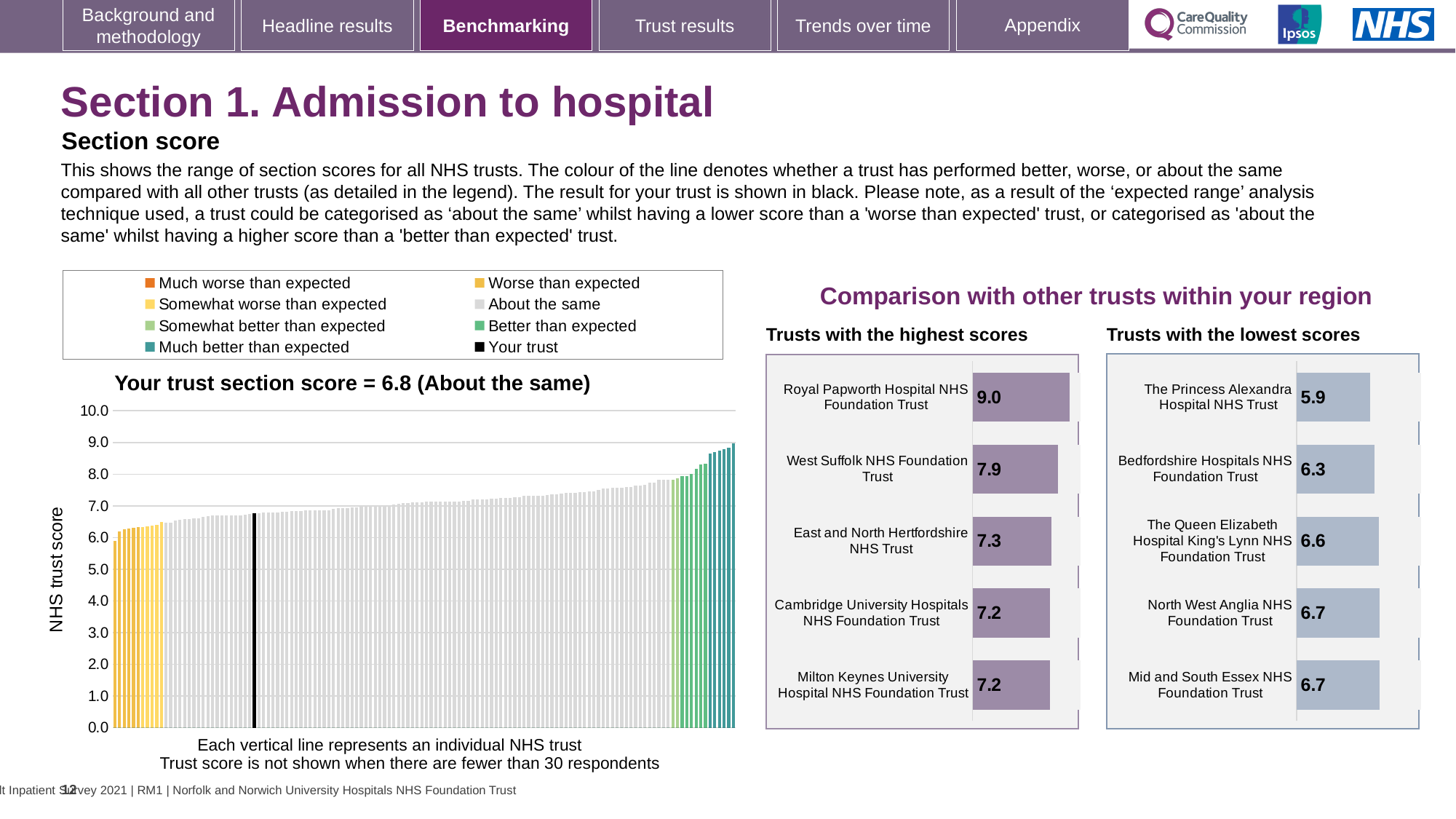
In the main chart on the left, is the value of the tallest bar greater or less than 8.0? greater In the 'Trusts with the highest scores' chart, what is the score for Royal Papworth Hospital NHS Foundation Trust? 9.0 In the 'Trusts with the lowest scores' chart, what is the score for Bedfordshire Hospitals NHS Foundation Trust? 6.3 How many entries does the legend above the main chart on the left list? 8 In the 'Trusts with the lowest scores' chart, which trust has the lowest score? The Princess Alexandra Hospital NHS Trust In the 'Trusts with the highest scores' chart, what is the difference between the scores of Royal Papworth Hospital NHS Foundation Trust and East and North Hertfordshire NHS Trust? 1.7 In the 'Trusts with the lowest scores' chart, which is larger: the score for The Queen Elizabeth Hospital King's Lynn NHS Foundation Trust or for Bedfordshire Hospitals NHS Foundation Trust? The Queen Elizabeth Hospital King's Lynn NHS Foundation Trust In the main chart on the left, do the trust scores rise or fall from left to right along the x axis? Rise What kind of chart is the main chart on the left showing the range of section scores for all NHS trusts? Bar chart According to the title of the main chart on the left, what is your trust's section score? 6.8 In the 'Trusts with the highest scores' chart, what is the score for West Suffolk NHS Foundation Trust? 7.9 How many trusts are shown in the 'Trusts with the highest scores' chart? 5